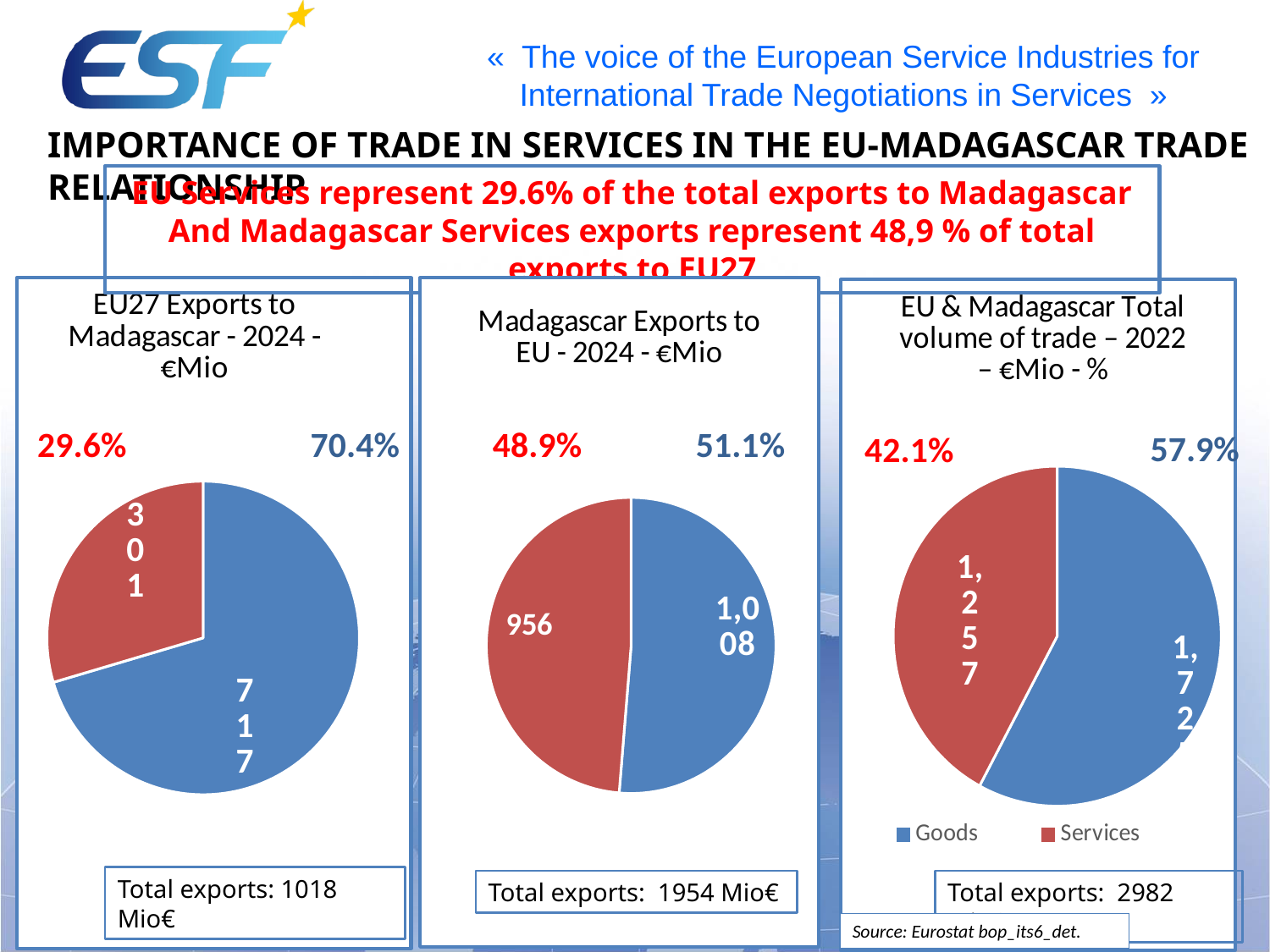
In the 'EU27 Exports to Madagascar - 2024 - €Mio' chart, what value is printed on the red (Services) slice? 301 In the 'EU & Madagascar Total volume of trade – 2022' chart, which category has the largest share? Goods In the 'EU27 Exports to Madagascar - 2024 - €Mio' chart, what percentage share does the red (Services) slice have? 29.6% In the 'EU27 Exports to Madagascar - 2024 - €Mio' chart, what value is printed on the blue (Goods) slice? 717 In the 'EU27 Exports to Madagascar - 2024 - €Mio' chart, what is the difference between the blue slice value and the red slice value? 416 What kind of chart is used in the 'EU27 Exports to Madagascar - 2024 - €Mio' chart? Pie chart In the 'EU & Madagascar Total volume of trade – 2022' chart, what percentage share does the Services slice have? 42.1% In the 'Madagascar Exports to EU - 2024 - €Mio' chart, what percentage share does the blue (Goods) slice have? 51.1% In the 'EU & Madagascar Total volume of trade – 2022' chart, what value is printed on the Services slice? 1,257 In the 'Madagascar Exports to EU - 2024 - €Mio' chart, which slice is larger, the blue one (1,008) or the red one (956)? The blue (Goods) slice In the 'Madagascar Exports to EU - 2024 - €Mio' chart, what value is printed on the red (Services) slice? 956 How many pie charts are shown on the slide? 3